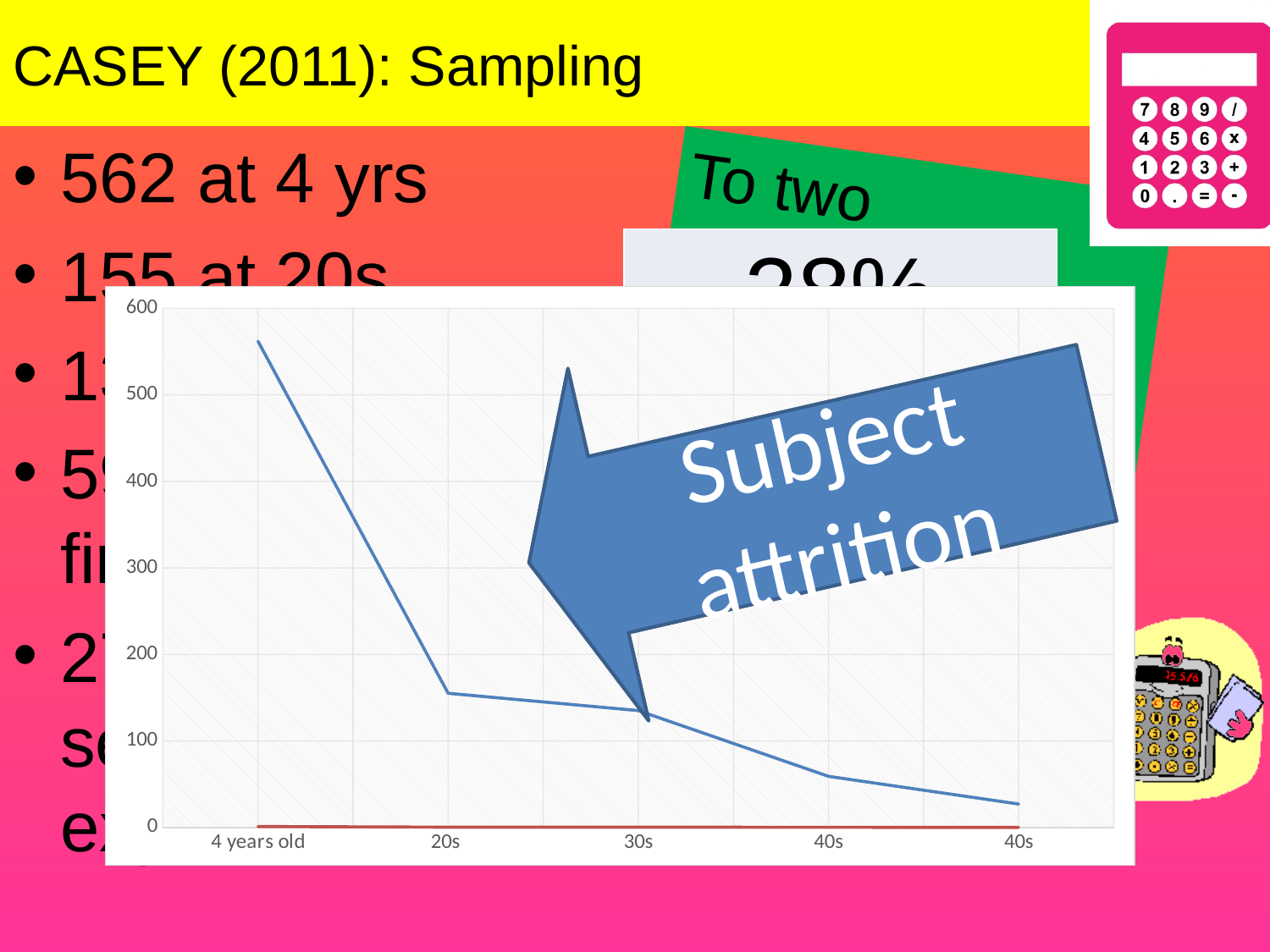
Is the value for 30s greater or less than 100? greater Do the values in the chart rise or fall from left to right along the x axis? fall Which category has the highest value in the chart? 4 years old What is the highest tick value shown on the y axis of the chart? 600 What kind of chart is shown on the slide? line chart Is the value for 20s greater or less than 200? less Which has the larger value, 20s or the first 40s category? 20s How many categories are shown along the x axis of the chart? 5 Is the value for the first 40s category greater or less than 100? less Which has the larger value, 4 years old or 20s? 4 years old